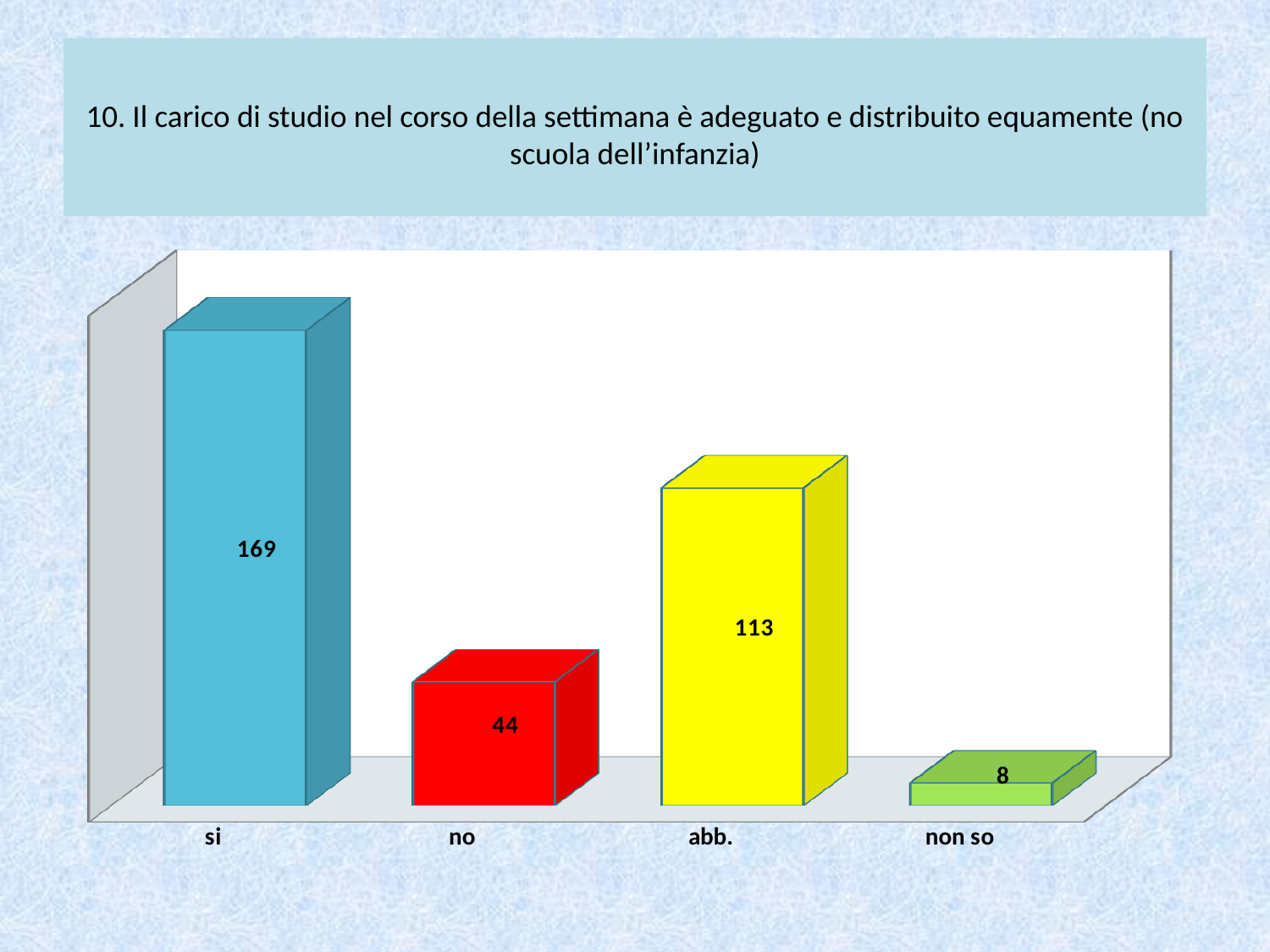
How many categories are shown on the x axis? 4 What is the value for "si"? 169 Which category has the highest value? si What is the value for "abb."? 113 What is the value for "no"? 44 Which is larger, the value for "no" or the value for "abb."? abb. What is the difference between the values for "si" and "abb."? 56 What kind of chart is shown on the slide? bar chart What is the difference between the values for "no" and "non so"? 36 What colour is the bar for "abb."? yellow What is the value for "non so"? 8 Which category has the lowest value? non so